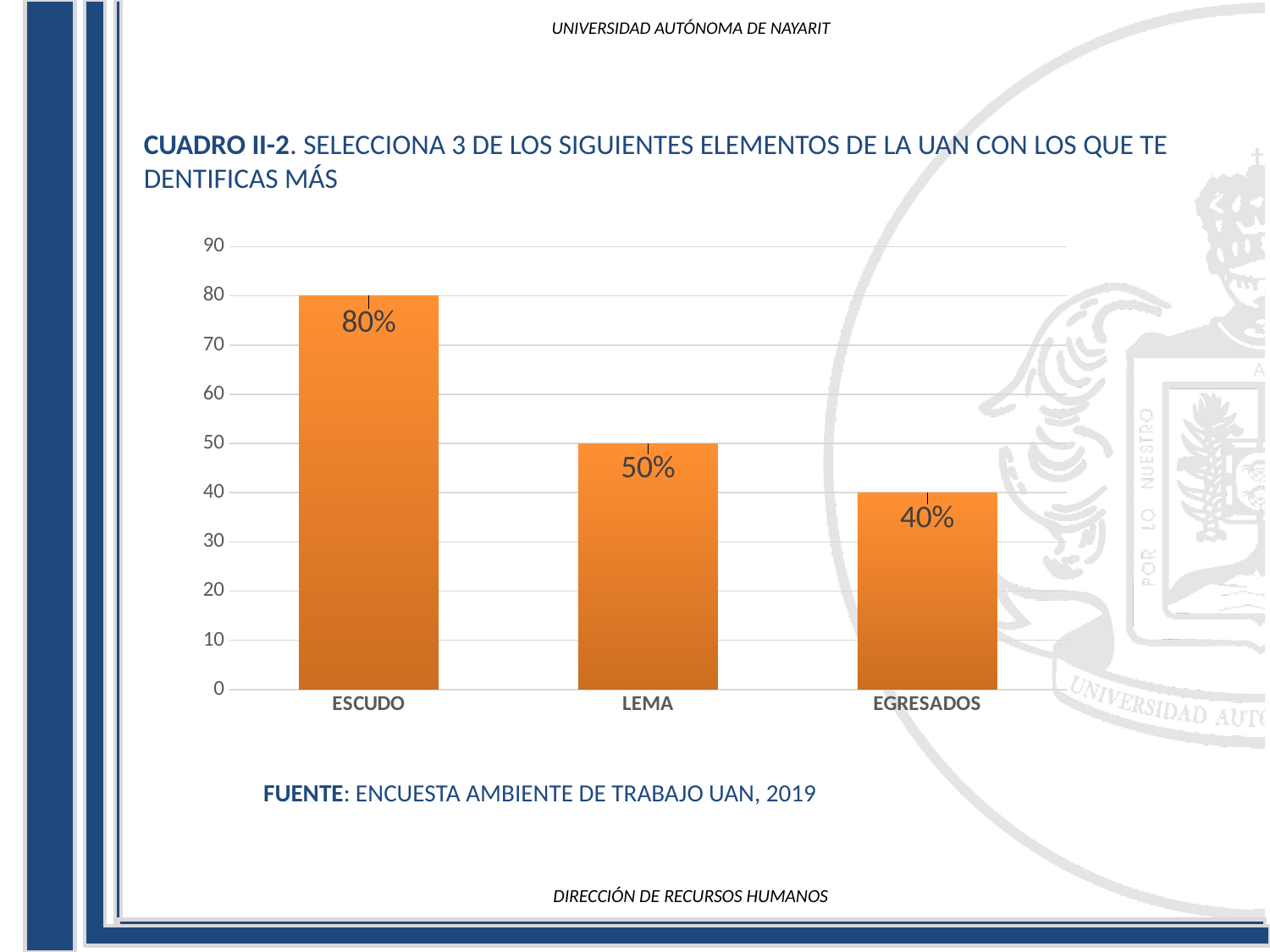
Which category has the highest value? ESCUDO What is the difference between the values for LEMA and EGRESADOS? 10% What kind of chart is shown on the slide? bar chart How many categories are shown in the chart? 3 Do the values rise or fall from left to right across the categories? fall What is the value for LEMA? 50% What is the difference between the values for ESCUDO and LEMA? 30% What is the value for ESCUDO? 80% Is the value for ESCUDO greater or less than 70? greater Which category has the lowest value? EGRESADOS Which is larger, the value for LEMA or the value for EGRESADOS? LEMA What is the value for EGRESADOS? 40%